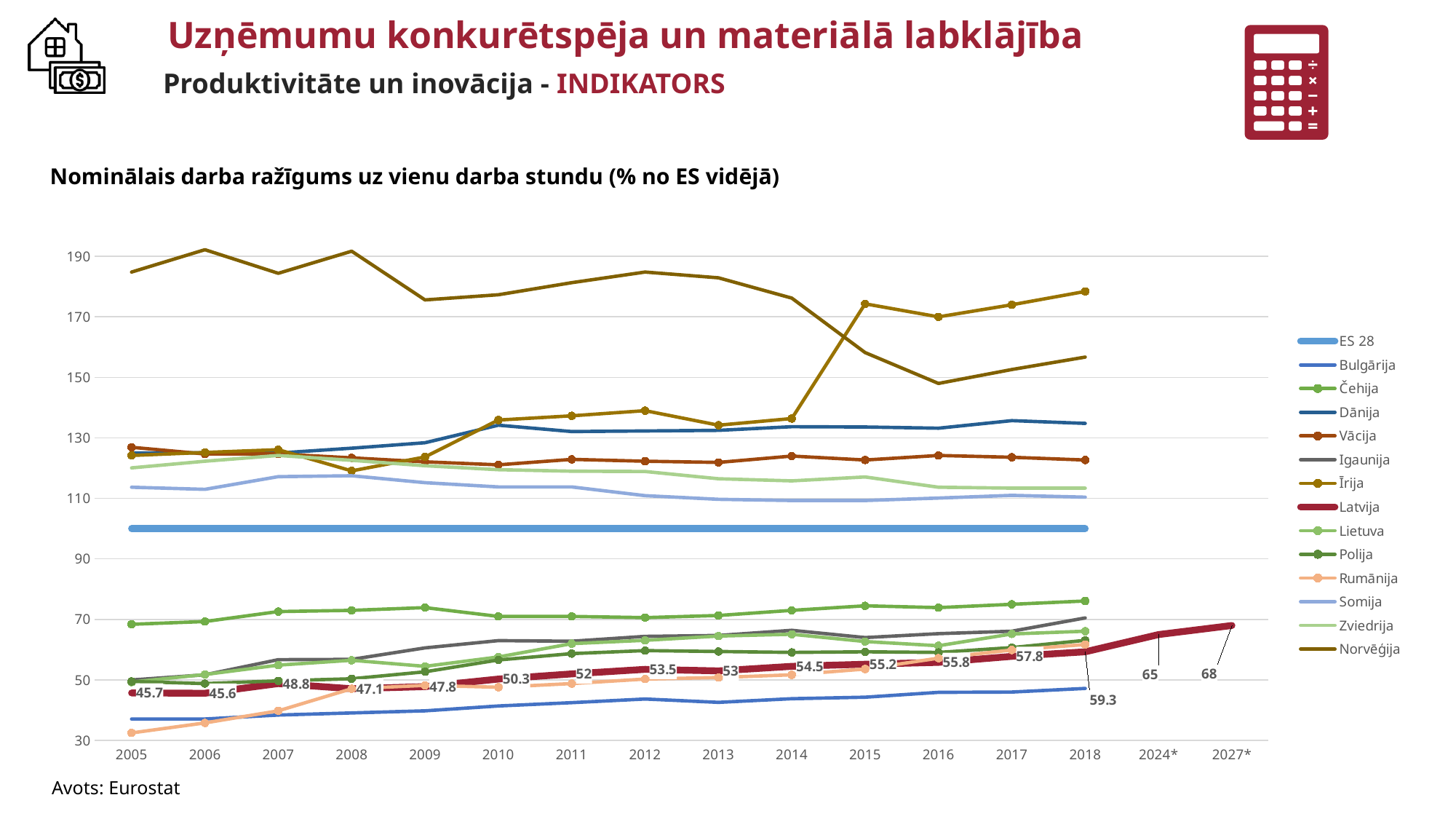
What is the projected value for Latvija in 2024*? 65 What is the title of the chart? Nominālais darba ražīgums uz vienu darba stundu (% no ES vidējā) Which is larger for Latvija: the value in 2016 or in 2017? 2017 How many series does the legend list? 14 By how much did the value for Latvija increase from 2005 to 2018? 13.6 Which series has the highest value in 2005? Norvēģija What is the value for Latvija in 2018? 59.3 Is the value for Bulgārija in 2005 greater or less than 50? less What kind of chart is shown on the slide? line chart Does the value for Latvija generally rise or fall from 2005 to 2027*? rise What is the projected value for Latvija in 2027*? 68 What is the value for Latvija in 2005? 45.7